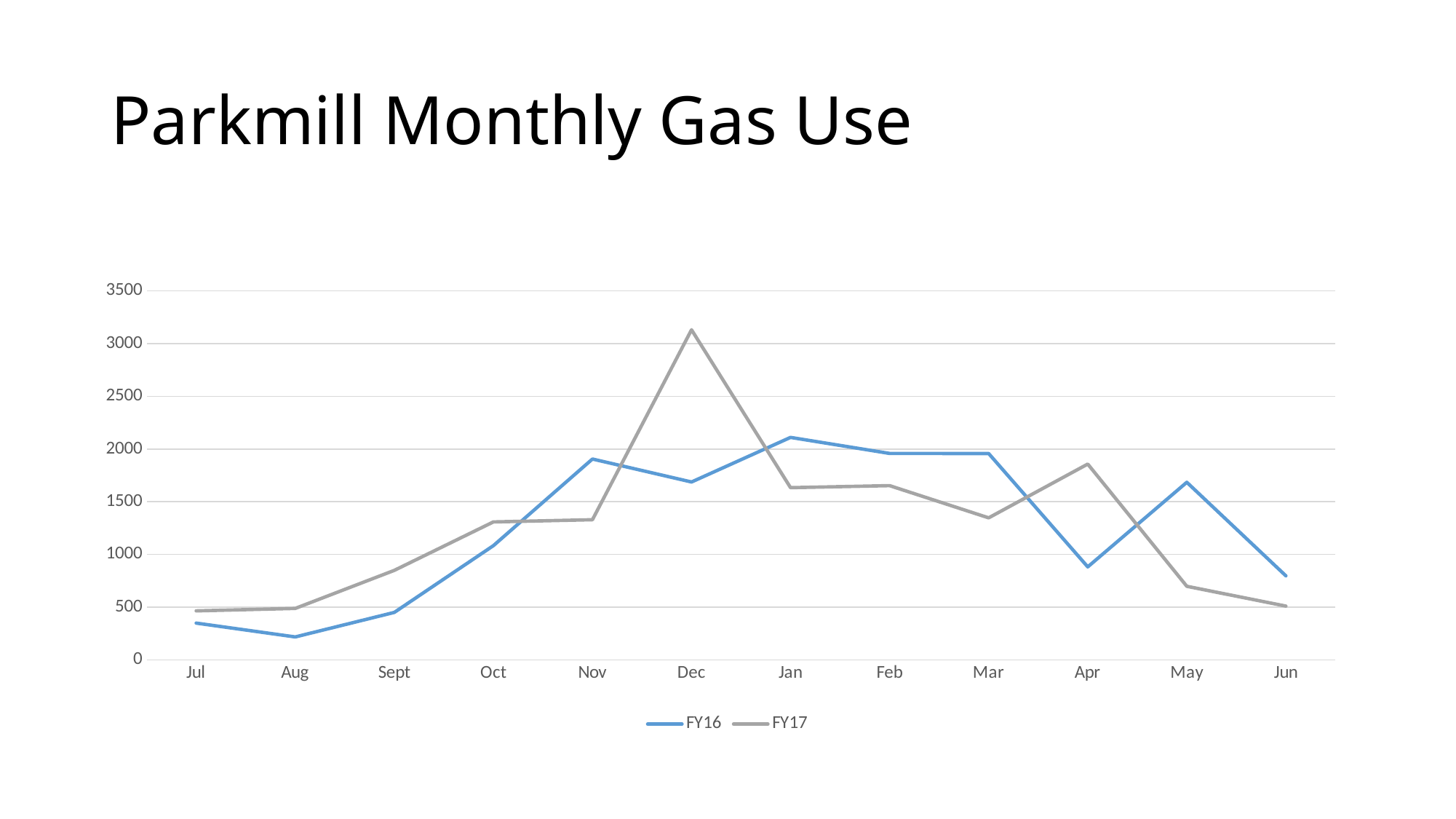
In Dec, which series has the higher value, FY16 or FY17? FY17 In which month does the FY16 series reach its lowest value? Aug In which month does the FY17 series reach its highest value? Dec Is the FY16 value for Jan greater or less than 2000? greater Is the FY16 value for Apr greater or less than 1000? less Does the FY16 series rise or fall from Jul to Nov? rise Is the FY17 value for Dec greater or less than 3000? greater In May, which series has the higher value, FY16 or FY17? FY16 What kind of chart is shown on the slide? line chart How many months are plotted along the x axis? 12 How many series does the legend list? 2 In which month does the FY16 series reach its highest value? Jan